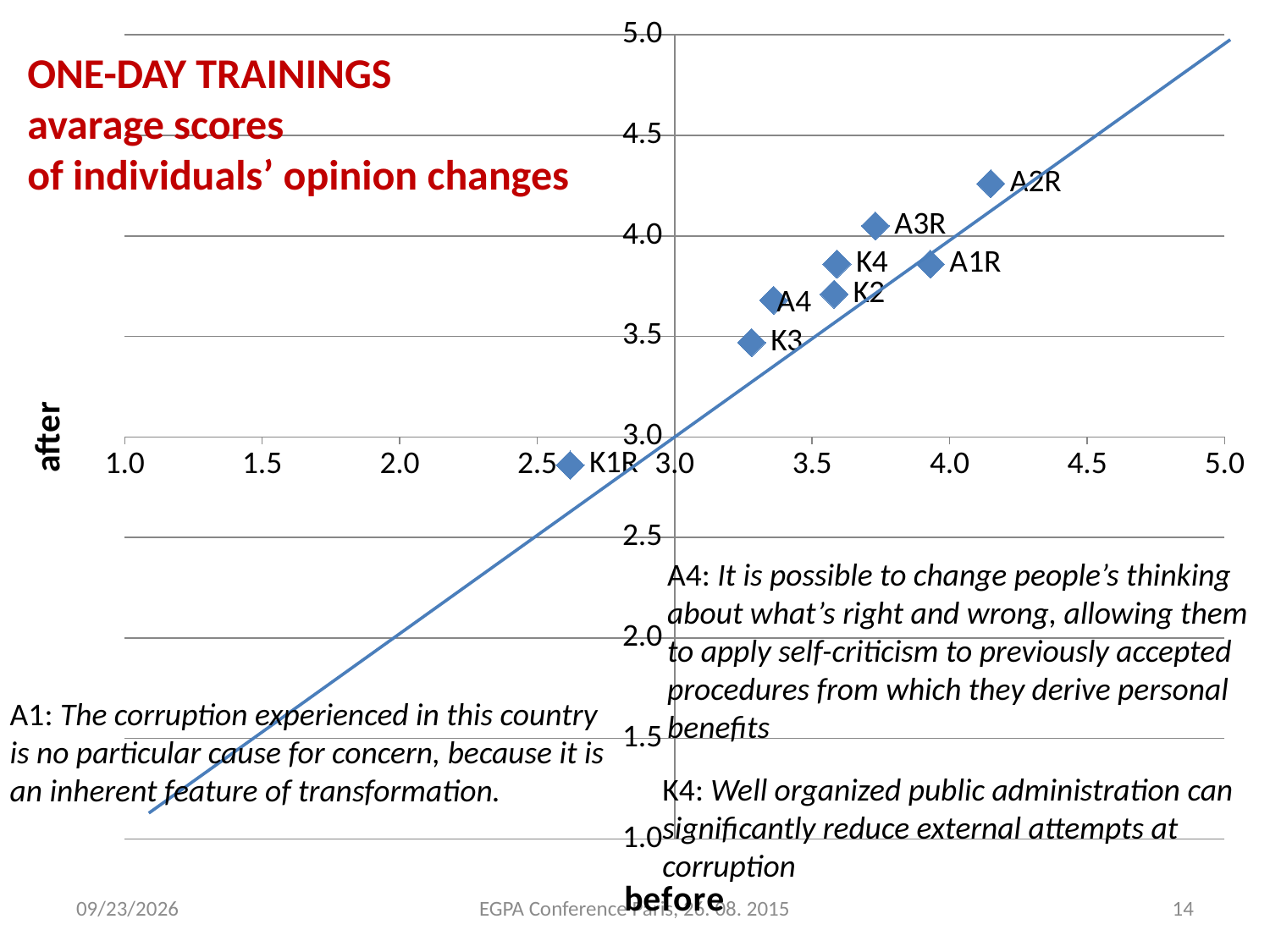
Which has the higher 'before' score, A2R or A3R? A2R Is the 'before' value for K1R greater or less than 3.0? less Which has the higher 'after' score, A2R or K1R? A2R Is the 'after' value for A2R greater or less than 4.0? greater What kind of chart is shown on the slide? scatter chart Is the 'after' value for A4 greater or less than 3.5? greater What is the label of the horizontal axis of the chart? before Which data point has the highest 'after' score? A2R Which data point has the lowest 'before' score? K1R How many labelled data points are plotted on the chart? 8 Which data point has the highest 'before' score? A2R